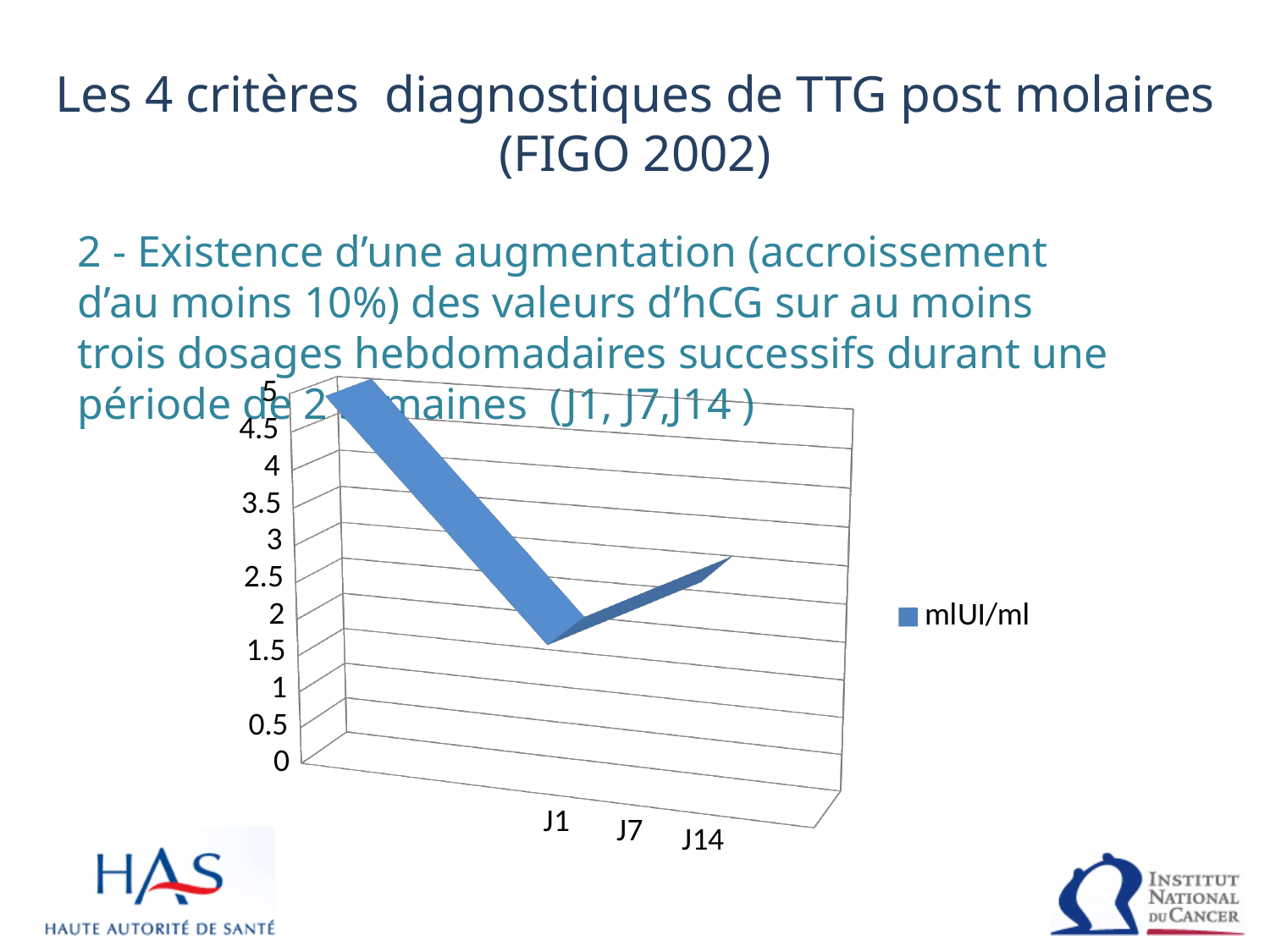
Which category has the lowest value in the chart? J1 What kind of chart is shown on the slide? line chart Which is larger, the value for J1 or the value for J7? J7 Is the value for J1 greater or less than 3? less What is the name of the series shown in the chart legend? mlUI/ml Which is larger, the value for J14 or the value for J7? J14 Is the value for J14 greater or less than 4? less How do the values change from J1 to J7 to J14 along the x axis? rise from J1 to J7, then rise again to J14 How many series does the chart legend list? 1 Is the value for J7 greater or less than 4? less